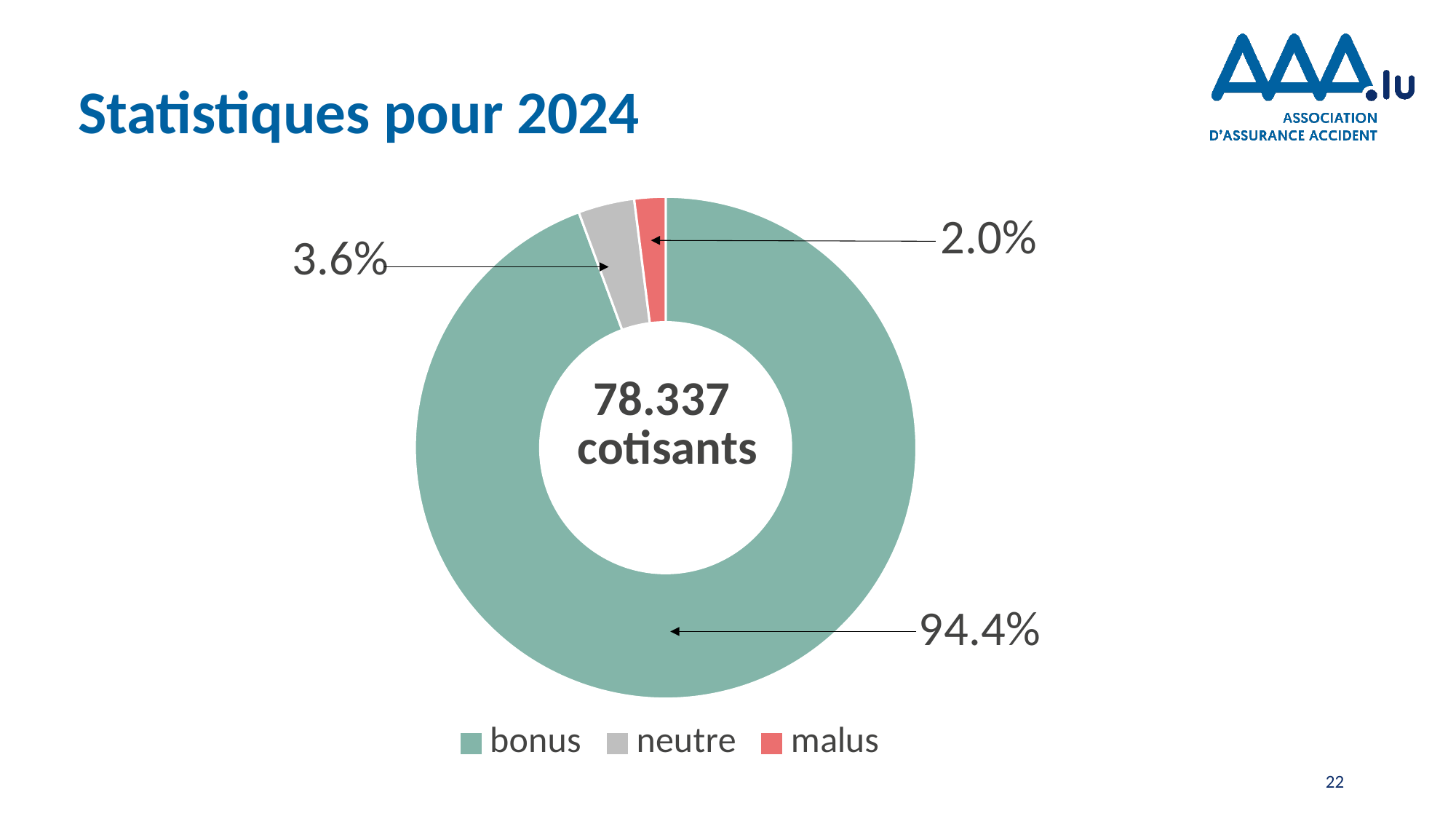
Which is larger, the neutre share or the malus share? neutre What share of the donut chart does the malus slice represent? 2.0% What share of the donut chart does the neutre slice represent? 3.6% What number of cotisants is shown in the centre of the chart? 78.337 What share of the donut chart does the bonus slice represent? 94.4% What is the difference in percentage points between the neutre and malus shares? 1.6 What kind of chart is shown on the slide? donut (pie) chart Which category has the smallest share in the chart? malus Which category has the largest share in the chart? bonus How many categories does the chart show? 3 What colour represents the malus category in the chart? red